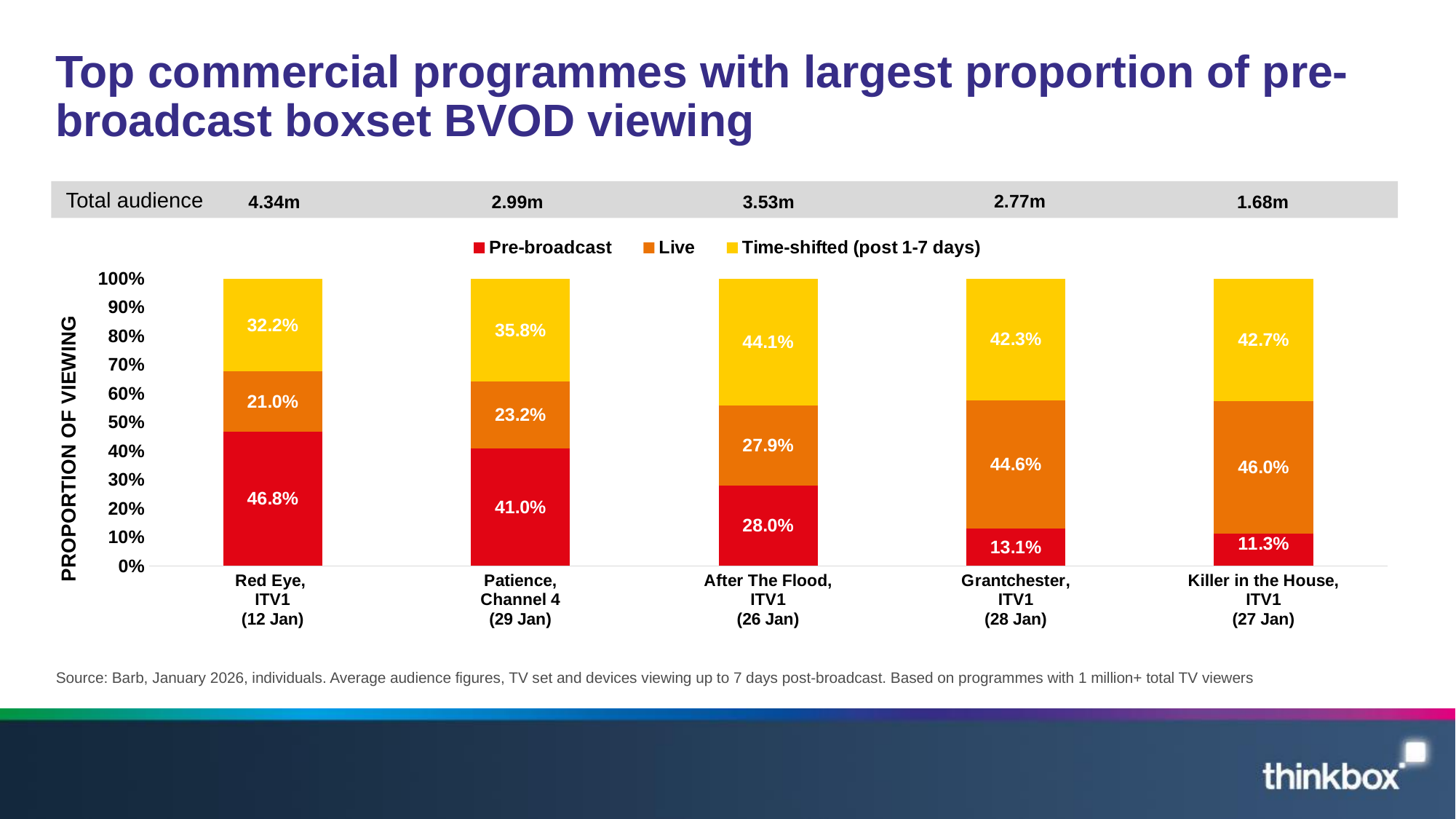
How many series does the legend list? 3 Which programme has the lowest Pre-broadcast proportion? Killer in the House, ITV1 (27 Jan) Which is larger: the Live proportion for Killer in the House or the Live proportion for Grantchester? Killer in the House Which programme has the highest Pre-broadcast proportion? Red Eye, ITV1 (12 Jan) What is the Live proportion for Grantchester, ITV1 (28 Jan)? 44.6% What is the Pre-broadcast proportion for Red Eye, ITV1 (12 Jan)? 46.8% What is the Time-shifted (post 1-7 days) proportion for After The Flood, ITV1 (26 Jan)? 44.1% What is the difference between the Pre-broadcast proportions for Red Eye and Patience? 5.8% What kind of chart is shown on the slide? Stacked bar chart What is the total audience shown for Patience, Channel 4 (29 Jan)? 2.99m Does the Pre-broadcast proportion rise or fall from left to right across the programmes? Fall How many programmes are shown in the chart? 5